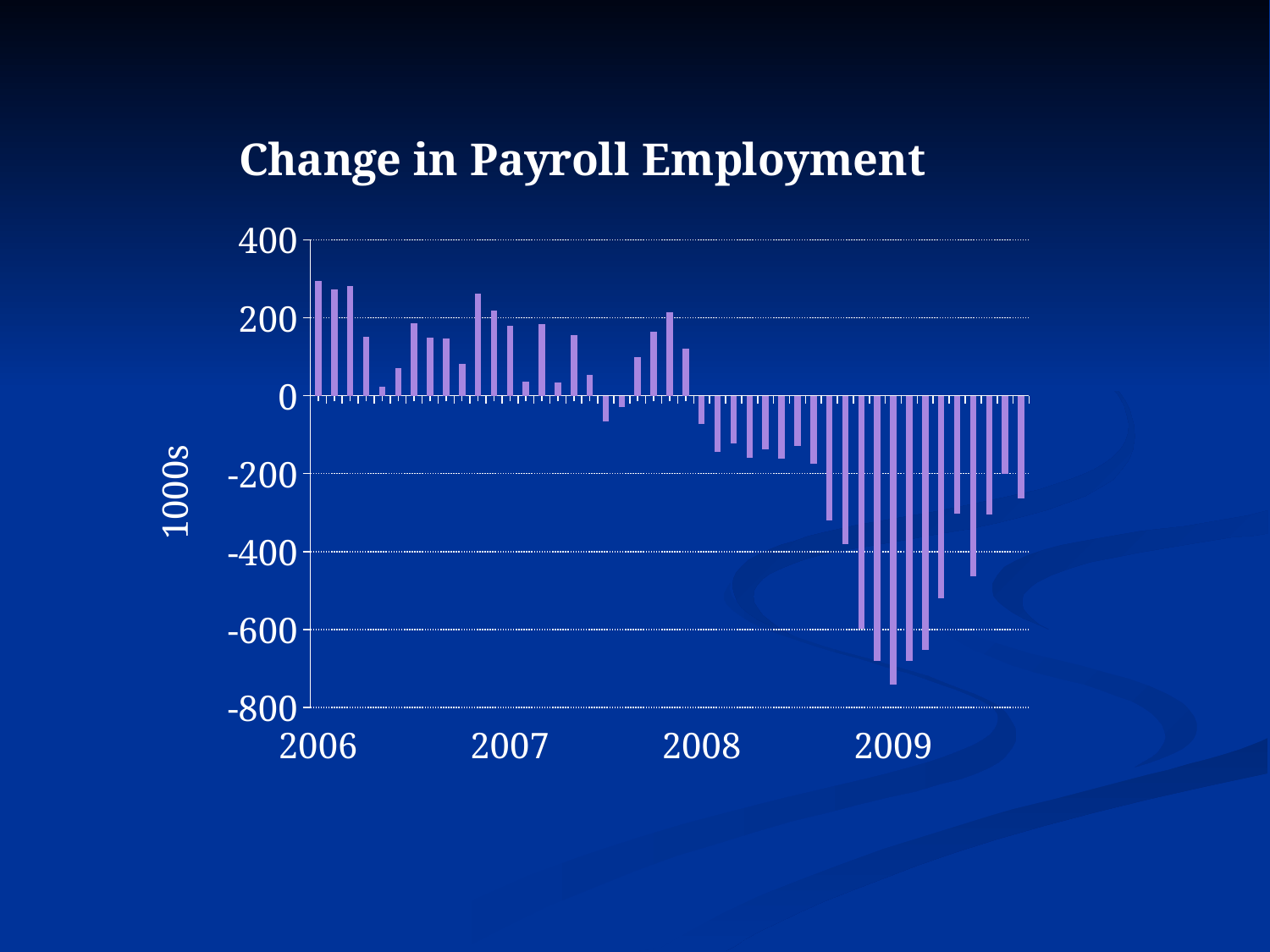
Which year on the x axis contains the highest bar in the chart? 2006 Is the value of the first bar at the 2006 label greater or less than 200? greater Is the value of the highest bar in the chart greater or less than 200? greater Is the value of the highest bar in the chart greater or less than 400? less Do the values in the chart generally rise or fall from 2006 to 2009? fall Which is larger, the first bar at the 2006 label or the first bar at the 2009 label? the first bar at 2006 What label is shown on the vertical axis of the chart? 1000s What kind of chart is shown on the slide? bar chart How many year labels are shown along the x axis of the chart? 4 Which year on the x axis contains the lowest bar in the chart? 2009 What is the title of the chart? Change in Payroll Employment